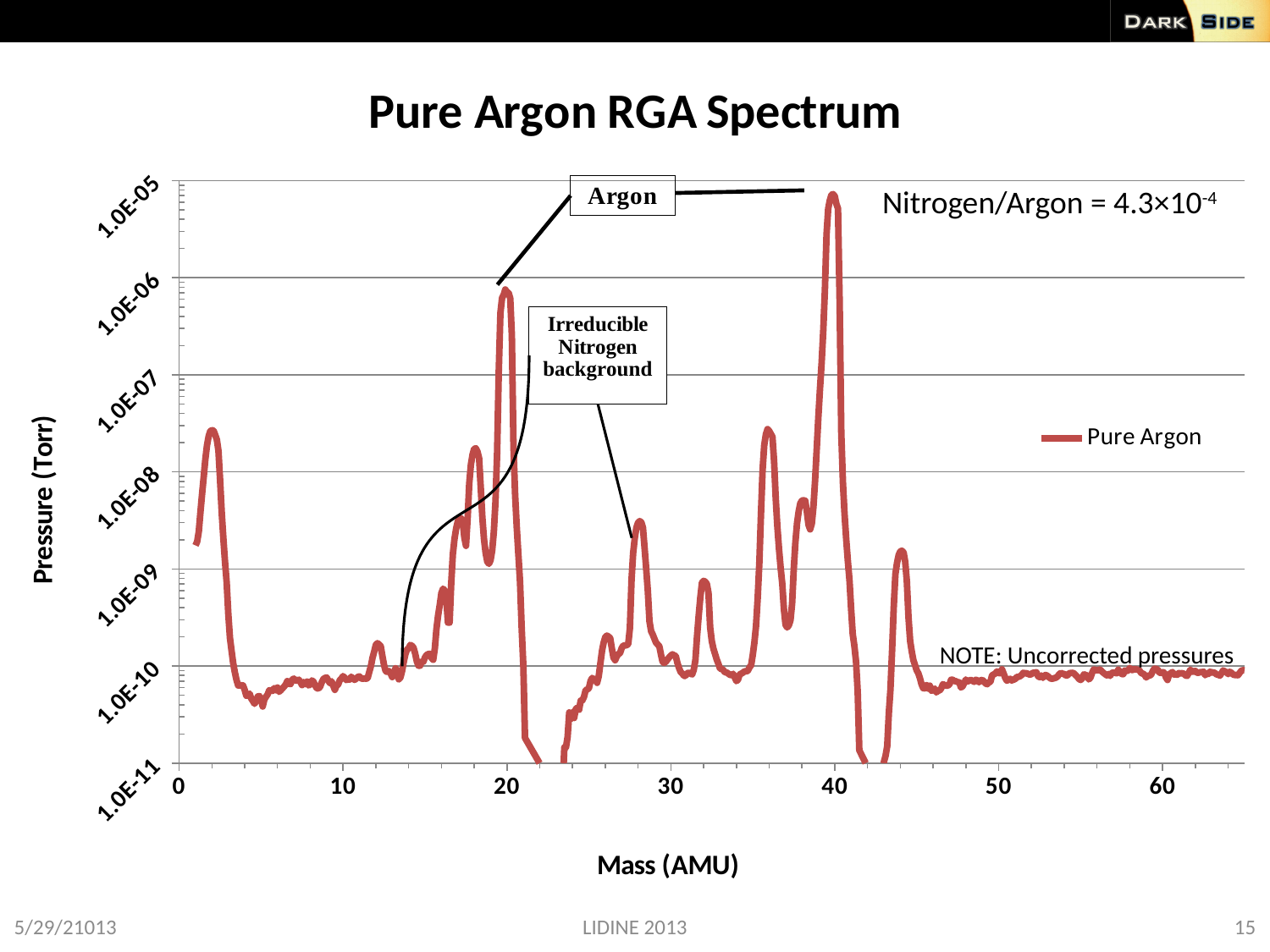
Is the peak pressure at mass 28 greater or less than 1.0E-08 Torr? less Is the peak pressure at mass 40 greater or less than 1.0E-06 Torr? greater How many series does the chart's legend list? 1 Is the peak pressure at mass 40 greater or less than 1.0E-05 Torr? less What kind of chart is shown on the slide? Line chart Which peak is higher: the one at mass 20 or the one at mass 40? mass 40 At which mass (AMU) does the spectrum reach its highest pressure? 40 Which peak is higher: the one at mass 28 or the one at mass 36? mass 36 What is the title of the chart? Pure Argon RGA Spectrum What Nitrogen/Argon ratio is stated on the chart? 4.3×10^-4